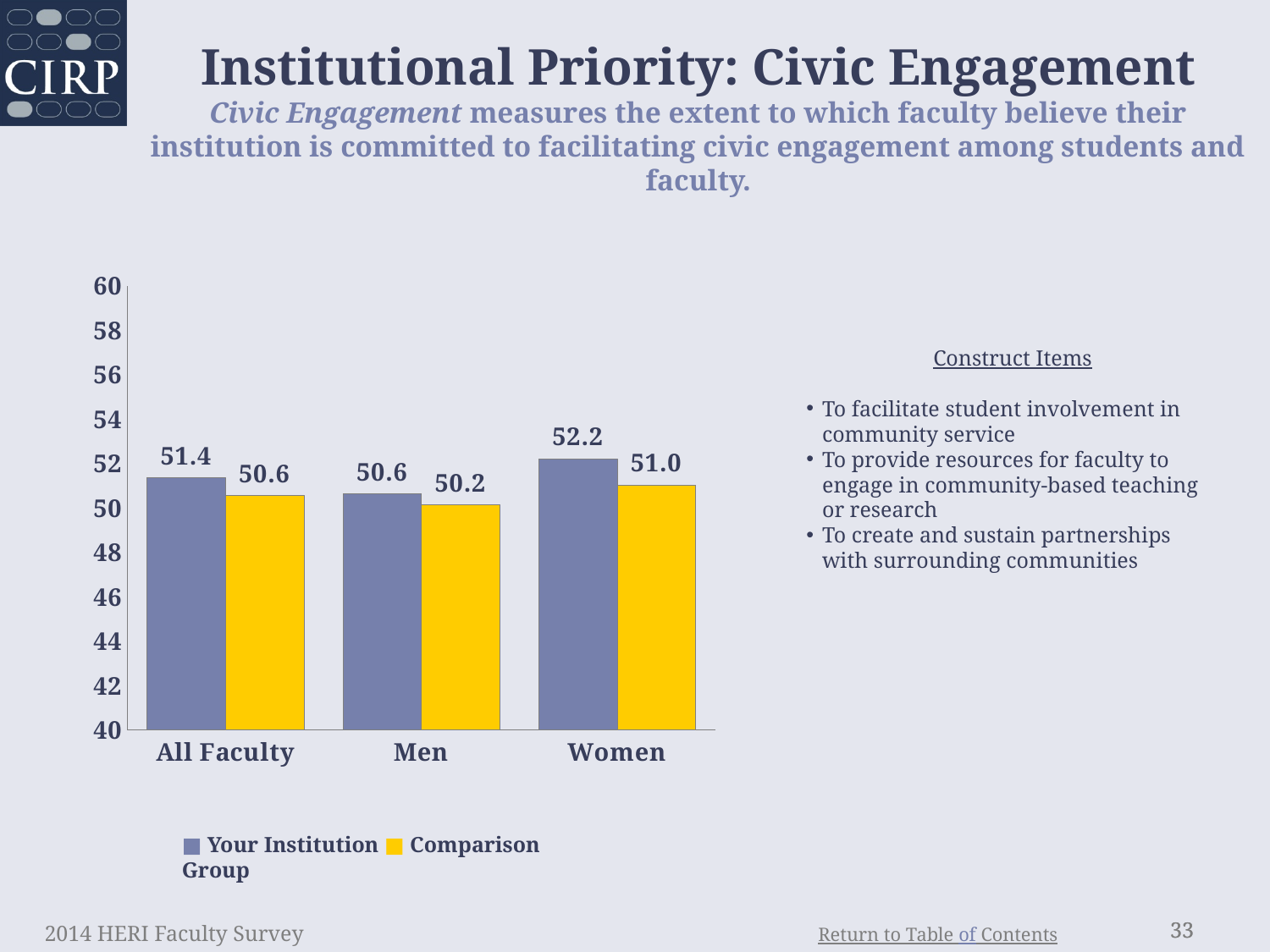
Which category has the lowest Comparison Group value? Men For All Faculty, which is larger: the Your Institution value or the Comparison Group value? Your Institution How many categories are shown on the x axis? 3 How many series does the legend list? 2 What is the Comparison Group value for Men? 50.2 What is the Your Institution value for All Faculty? 51.4 What is the difference between the Your Institution and Comparison Group values for Women? 1.2 What kind of chart is shown on the slide? bar chart What is the difference between the Your Institution values for Women and Men? 1.6 What colour are the Comparison Group bars? yellow What is the Your Institution value for Women? 52.2 Which category has the highest Your Institution value? Women